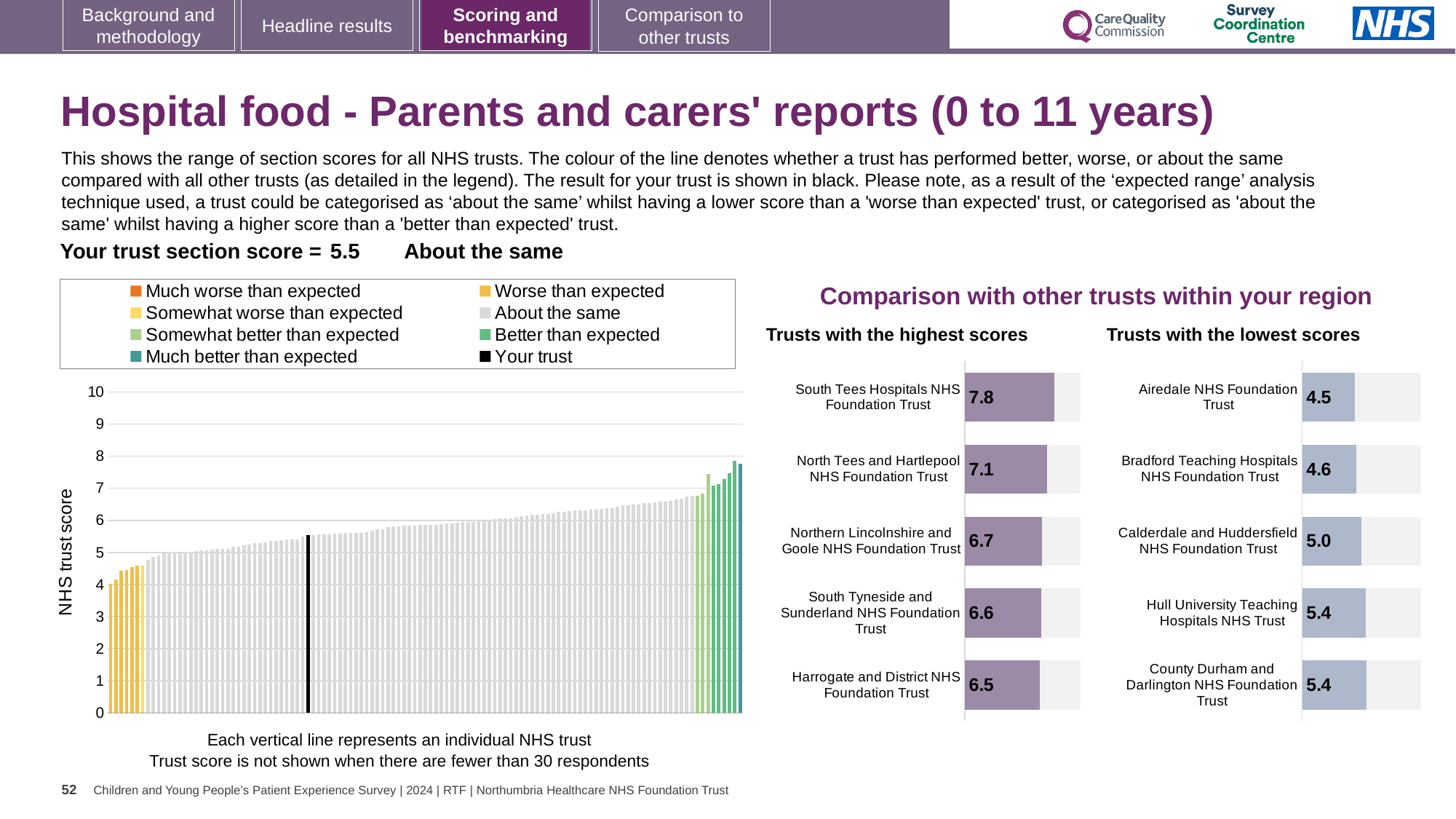
In the 'Trusts with the lowest scores' chart, which trust has the lowest score? Airedale NHS Foundation Trust In the 'Trusts with the highest scores' chart, what is the score for Harrogate and District NHS Foundation Trust? 6.5 In the 'Trusts with the highest scores' chart, what is the score for South Tees Hospitals NHS Foundation Trust? 7.8 How many entries does the legend of the main chart on the left list? 8 In the 'Trusts with the lowest scores' chart, what is the score for Calderdale and Huddersfield NHS Foundation Trust? 5.0 How many trusts are shown in the 'Trusts with the lowest scores' chart? 5 In the 'Trusts with the highest scores' chart, what is the difference between the scores of South Tees Hospitals NHS Foundation Trust and Harrogate and District NHS Foundation Trust? 1.3 In the 'Trusts with the highest scores' chart, which trust has the highest score? South Tees Hospitals NHS Foundation Trust In the 'Trusts with the lowest scores' chart, which has the larger score: Bradford Teaching Hospitals NHS Foundation Trust or Calderdale and Huddersfield NHS Foundation Trust? Calderdale and Huddersfield NHS Foundation Trust In the main chart on the left, do the trust scores rise or fall from left to right along the x axis? rise In the main chart on the left, is the value of the highest bar greater or less than 8? less In the main chart on the left showing the range of section scores, what is the score for your trust (the black bar)? 5.5